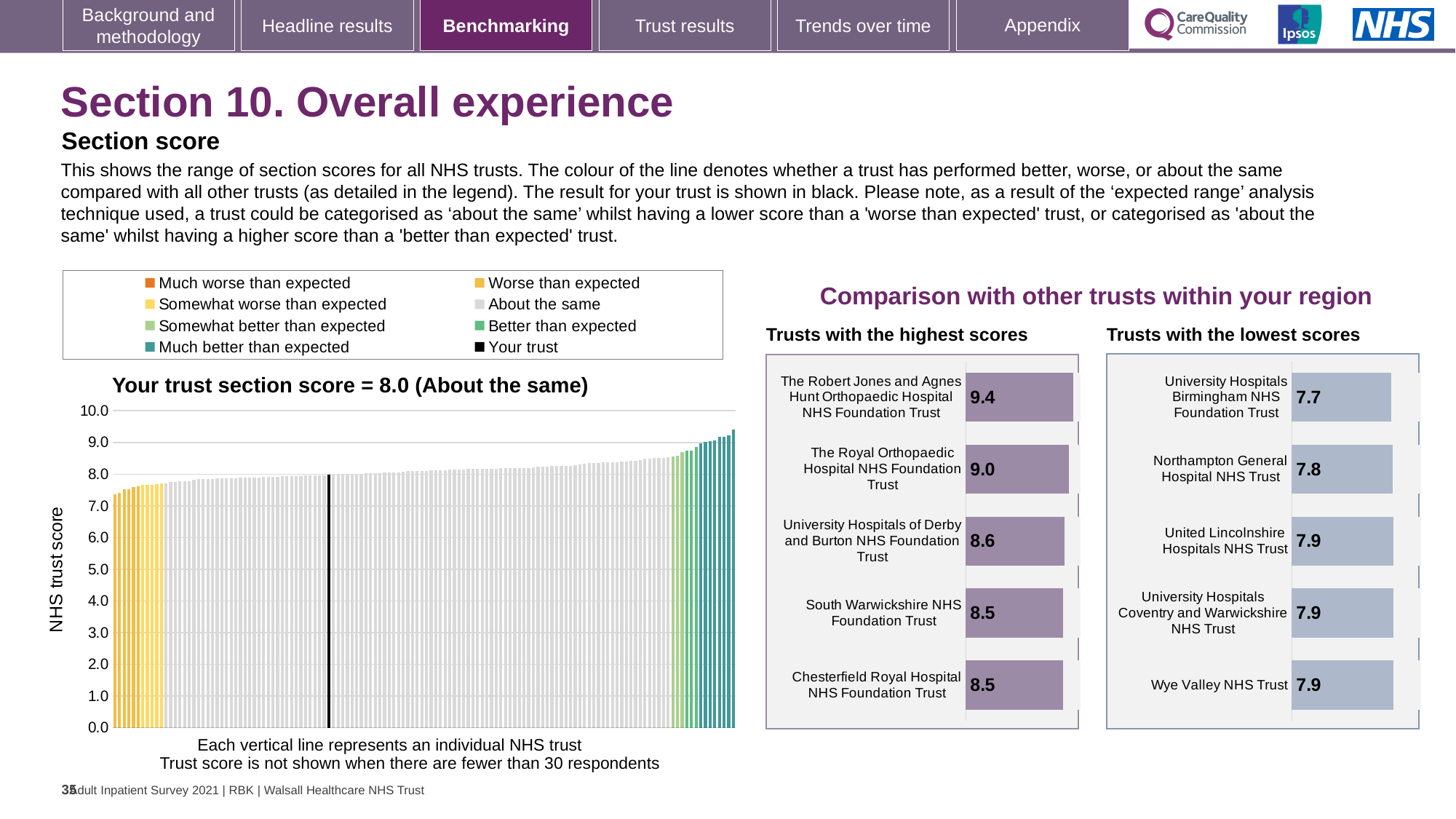
In the chart 'Trusts with the highest scores', what is the score for The Royal Orthopaedic Hospital NHS Foundation Trust? 9.0 In the chart titled 'Your trust section score', what is the section score for your trust? 8.0 In the chart 'Trusts with the highest scores', which trust has the highest score? The Robert Jones and Agnes Hunt Orthopaedic Hospital NHS Foundation Trust In the chart titled 'Your trust section score', what is the label on the vertical axis? NHS trust score In the chart 'Trusts with the lowest scores', how many trusts are shown? 5 In the chart titled 'Your trust section score', is the value of the lowest bar greater or less than 8.0? less In the chart 'Trusts with the lowest scores', which trust has the lowest score? University Hospitals Birmingham NHS Foundation Trust In the chart 'Trusts with the lowest scores', which has the larger score: Northampton General Hospital NHS Trust or University Hospitals Birmingham NHS Foundation Trust? Northampton General Hospital NHS Trust In the chart titled 'Your trust section score', do the bars rise or fall from left to right? rise In the chart titled 'Your trust section score', how many entries does the legend list? 8 In the chart titled 'Your trust section score', what kind of chart is shown? bar chart In the chart 'Trusts with the highest scores', what is the difference between the scores of The Robert Jones and Agnes Hunt Orthopaedic Hospital NHS Foundation Trust and University Hospitals of Derby and Burton NHS Foundation Trust? 0.8